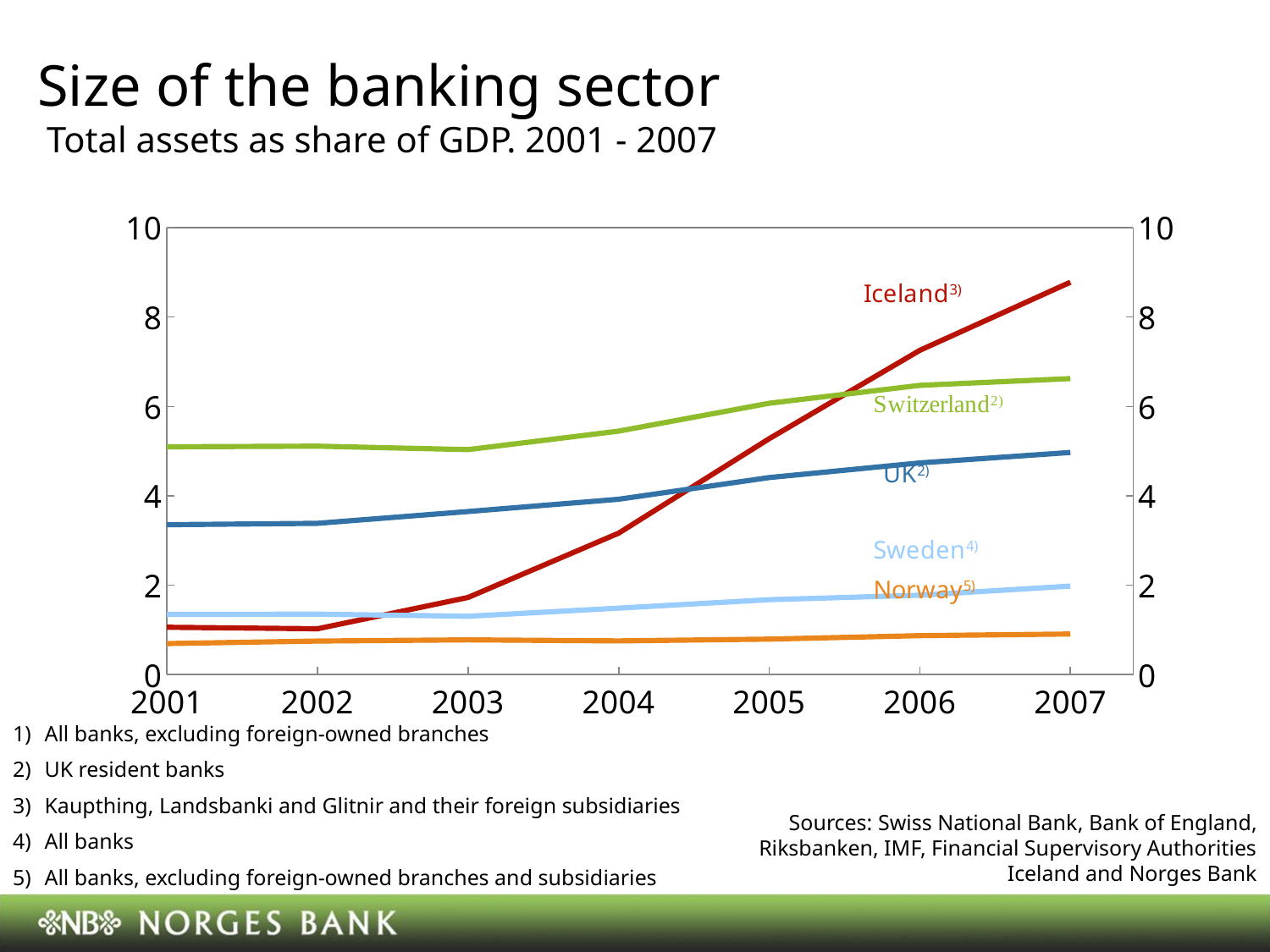
Is the value for Norway in 2007 greater or less than 2? less Which country has the lowest value in 2007? Norway Is the value for Switzerland in 2001 greater or less than 4? greater Does the value for Iceland rise or fall from 2003 to 2007? rise Which is larger in 2002, the value for Iceland or the value for Sweden? Sweden Which country has the highest value in 2001? Switzerland How many years are shown along the x axis? 7 How many countries are plotted as lines on the chart? 5 Is the value for Iceland in 2001 greater or less than 2? less What kind of chart is shown on the slide? line chart Which country has the highest value in 2007? Iceland